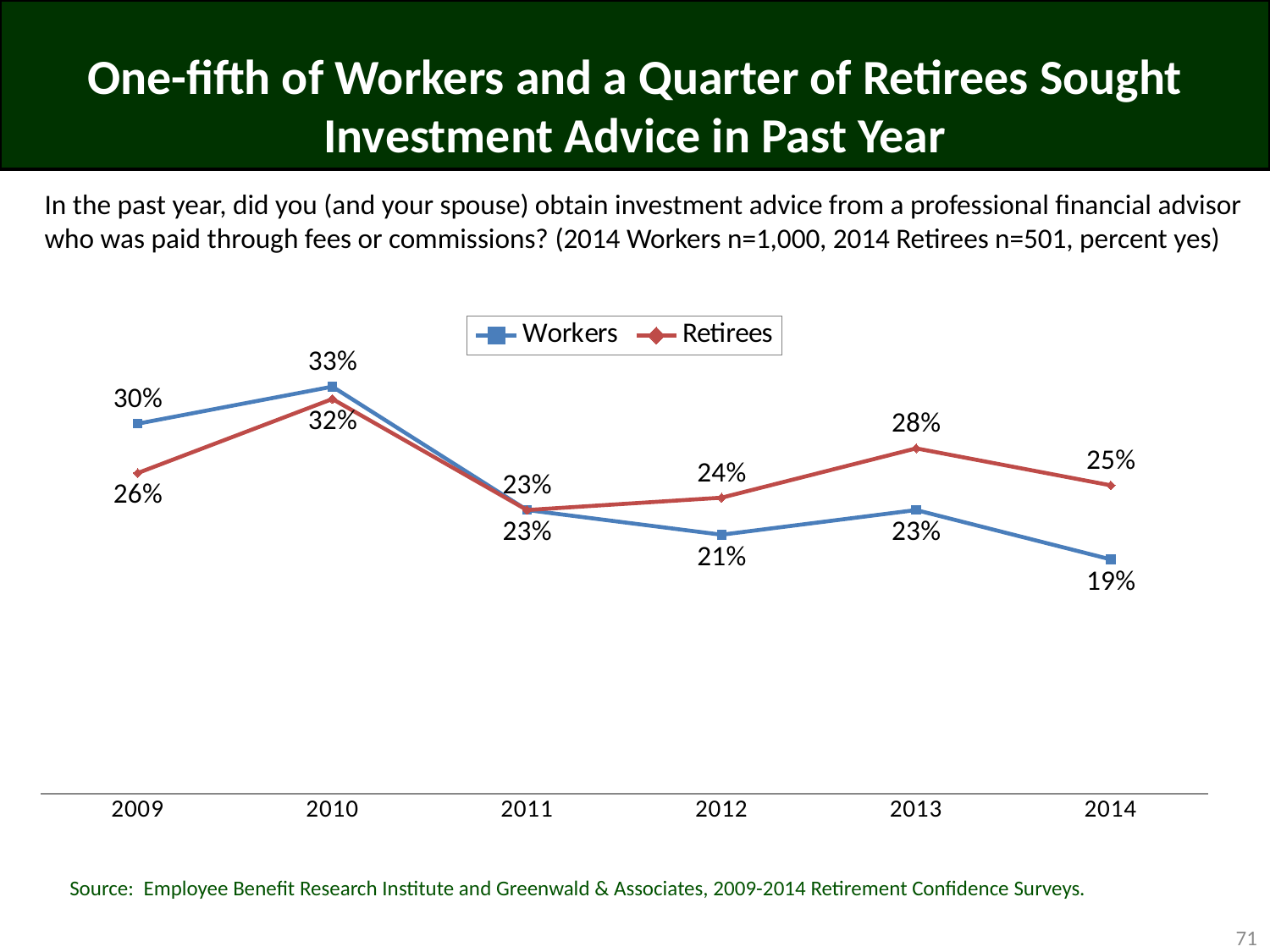
What is the difference between the Retirees and Workers values in 2014? 6 percentage points Which colour is used for the Retirees line? Red Did the Workers value rise or fall from 2013 to 2014? Fall What percentage of Workers obtained investment advice in 2014? 19% In which year was the Retirees value lowest? 2011 What percentage of Retirees obtained investment advice in 2013? 28% In which year was the Workers value highest? 2010 How many series does the legend list? 2 How many years are shown on the x axis? 6 What kind of chart is shown on the slide? Line chart What was the value for Workers in 2010? 33% Which series had the higher value in 2009, Workers or Retirees? Workers